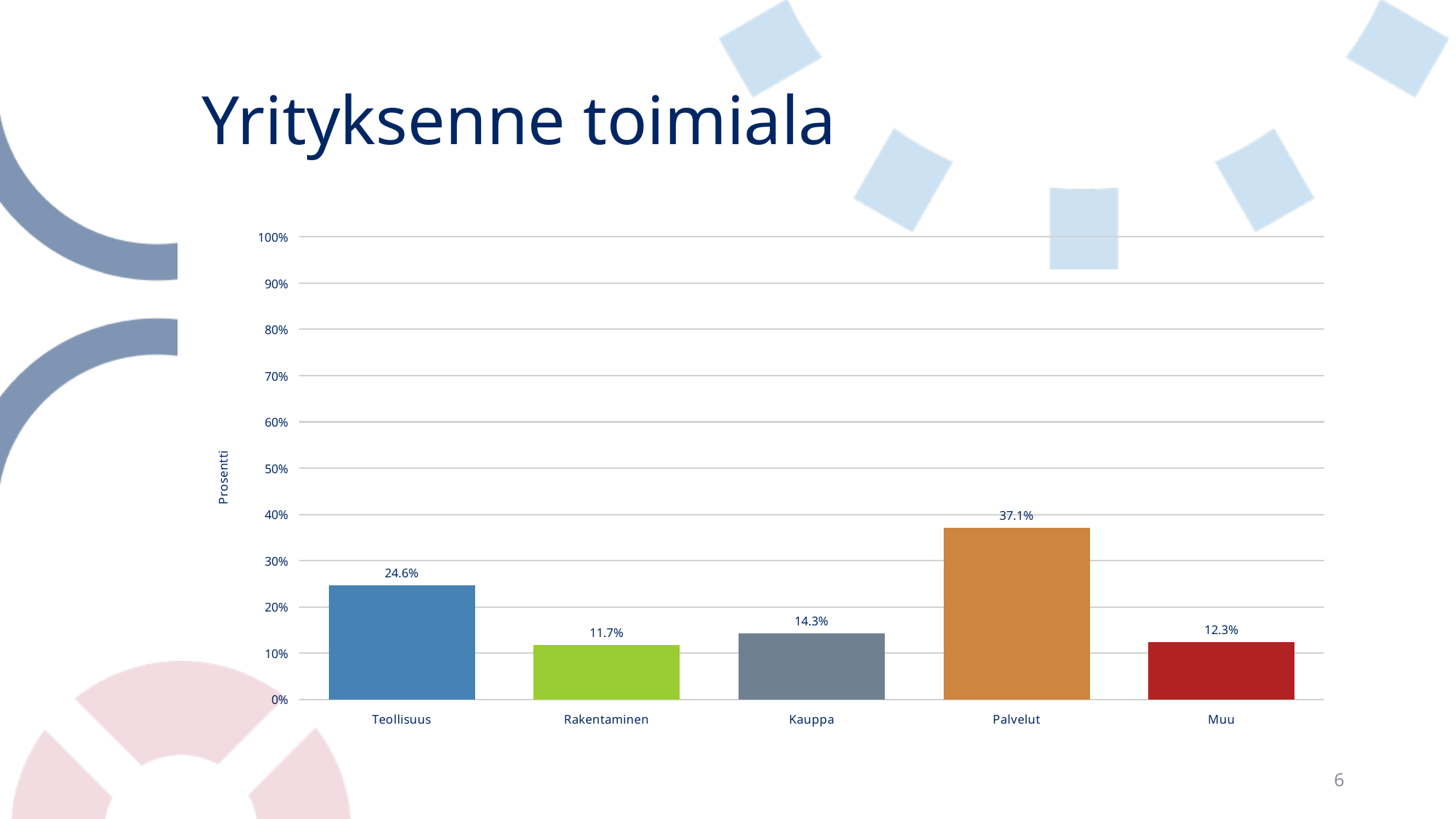
What is the difference between the values for Kauppa and Rakentaminen? 2.6% Is the value for Teollisuus greater or less than 20%? greater What is the value for Muu? 12.3% What is the label of the vertical axis? Prosentti Which is larger, the value for Kauppa or the value for Muu? Kauppa What is the value for Palvelut? 37.1% Which category has the highest value? Palvelut How many categories are shown on the x axis? 5 What is the difference between the values for Palvelut and Teollisuus? 12.5% What is the value for Teollisuus? 24.6% What kind of chart is shown on the slide? bar chart Which category has the lowest value? Rakentaminen